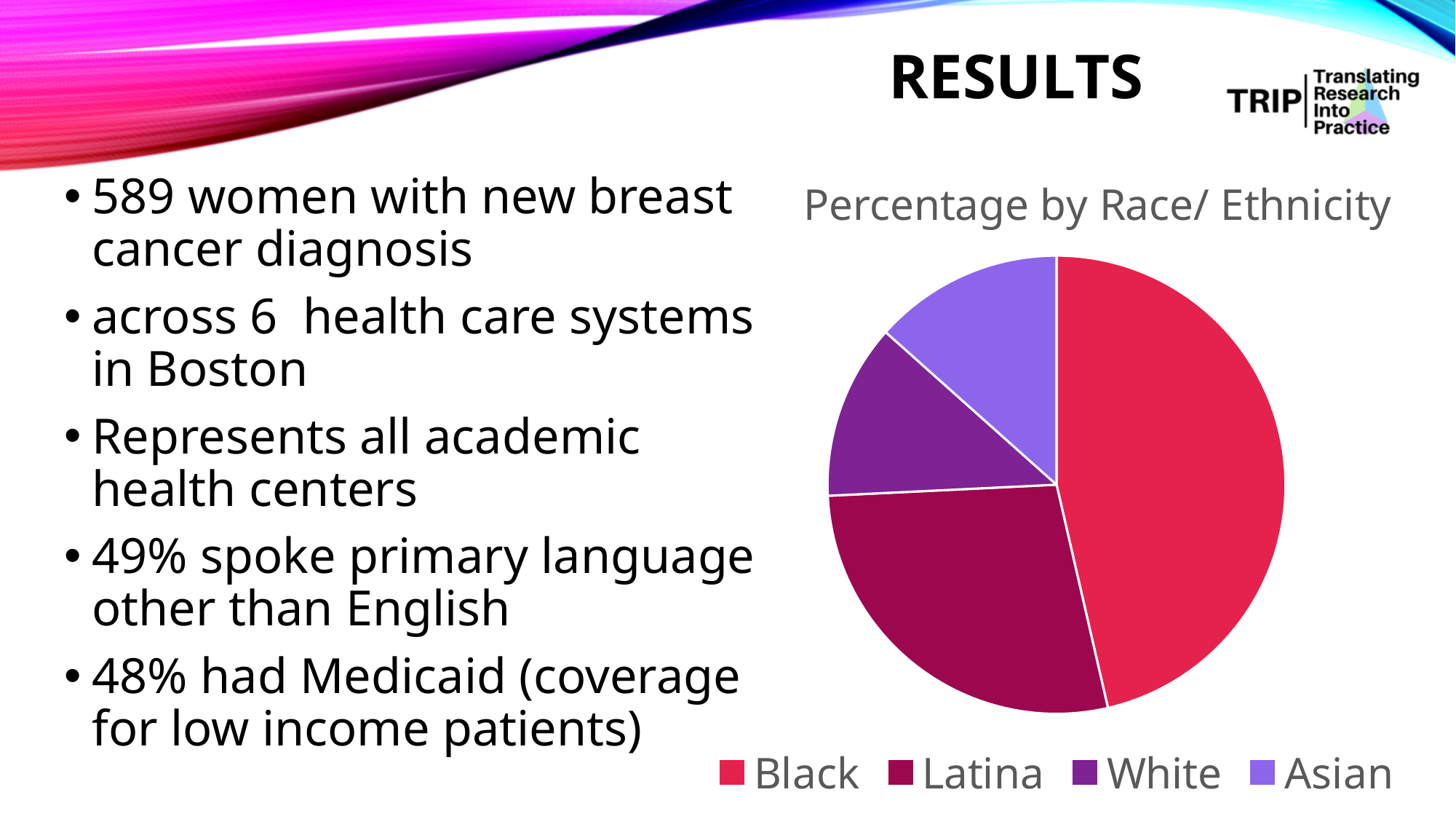
Which race/ethnicity group has the largest slice in the pie chart? Black Which slice is larger in the pie chart, Black or Asian? Black Which legend entry is shown in the lightest purple colour in the pie chart? Asian Which slice is larger in the pie chart, Latina or White? Latina How many slices does the pie chart have? 4 What is the title of the pie chart? Percentage by Race/ Ethnicity What kind of chart is shown on the slide? Pie chart How many entries does the legend of the pie chart list? 4 Which slice is larger in the pie chart, Black or Latina? Black